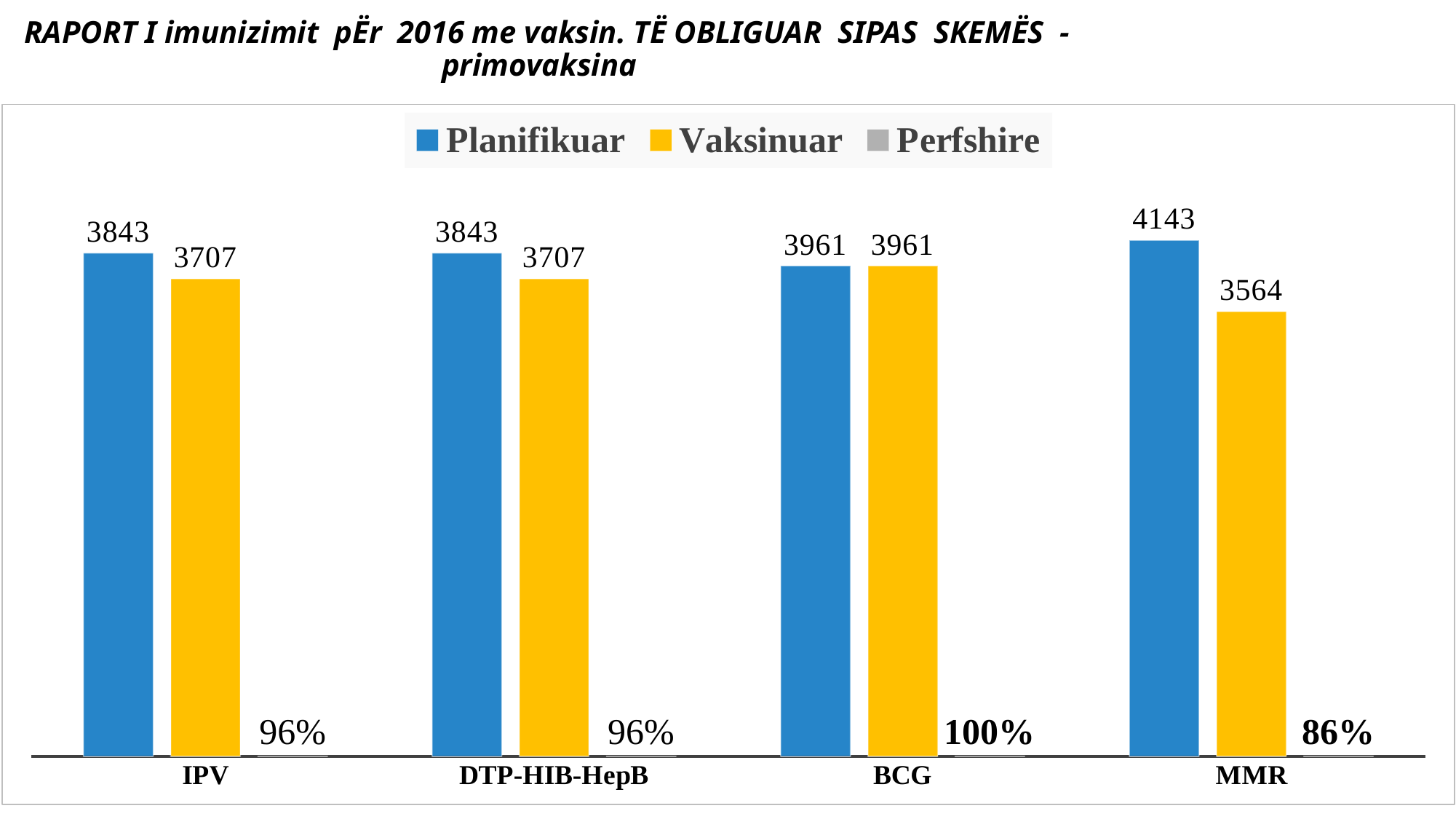
What kind of chart is shown on the slide? Bar chart What is the difference between the Planifikuar and Vaksinuar values for MMR? 579 Which category has the lowest Vaksinuar value? MMR What is the Perfshire value shown for BCG? 100% Which category has the highest Planifikuar value? MMR What is the Vaksinuar value for IPV? 3707 Which is larger, the Vaksinuar value for BCG or the Vaksinuar value for DTP-HIB-HepB? BCG What is the Perfshire value shown for MMR? 86% What is the Planifikuar value for MMR? 4143 How many series does the legend list? 3 What is the difference between the Planifikuar and Vaksinuar values for IPV? 136 How many categories are shown on the x axis? 4